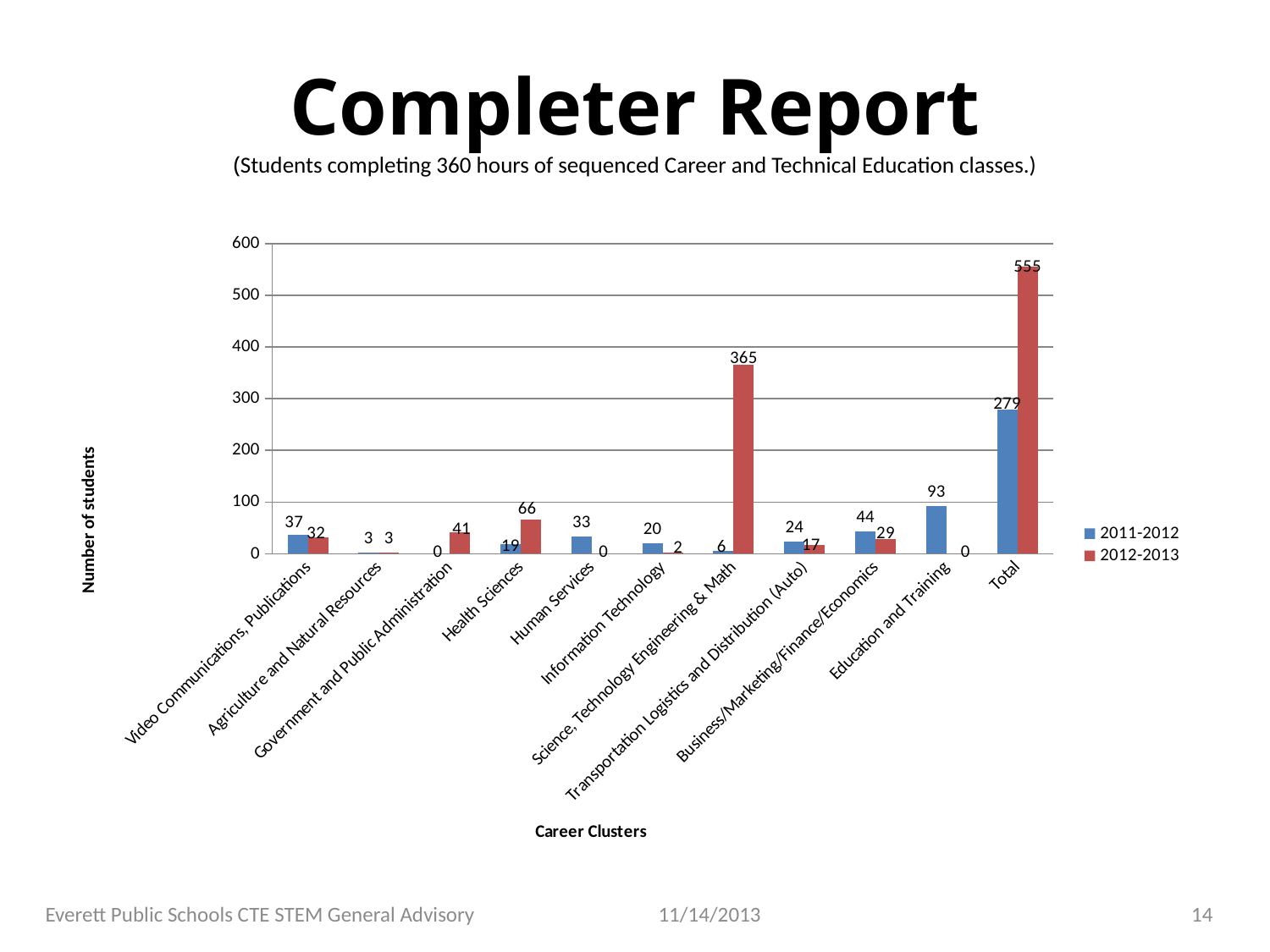
What is the difference between the 2012-2013 and 2011-2012 values for Total? 276 What is the 2011-2012 value for Education and Training? 93 Which is larger for Business/Marketing/Finance/Economics: the 2011-2012 value or the 2012-2013 value? 2011-2012 What kind of chart is shown on the slide? Bar chart What is the label of the vertical axis? Number of students What is the 2011-2012 value for Total? 279 What is the 2012-2013 value for Science, Technology Engineering & Math? 365 What is the 2012-2013 value for Health Sciences? 66 Excluding Total, which career cluster has the highest 2012-2013 value? Science, Technology Engineering & Math How many series does the legend list? 2 How many career cluster categories are shown on the x axis, including Total? 11 Excluding Total, which career cluster has the highest 2011-2012 value? Education and Training